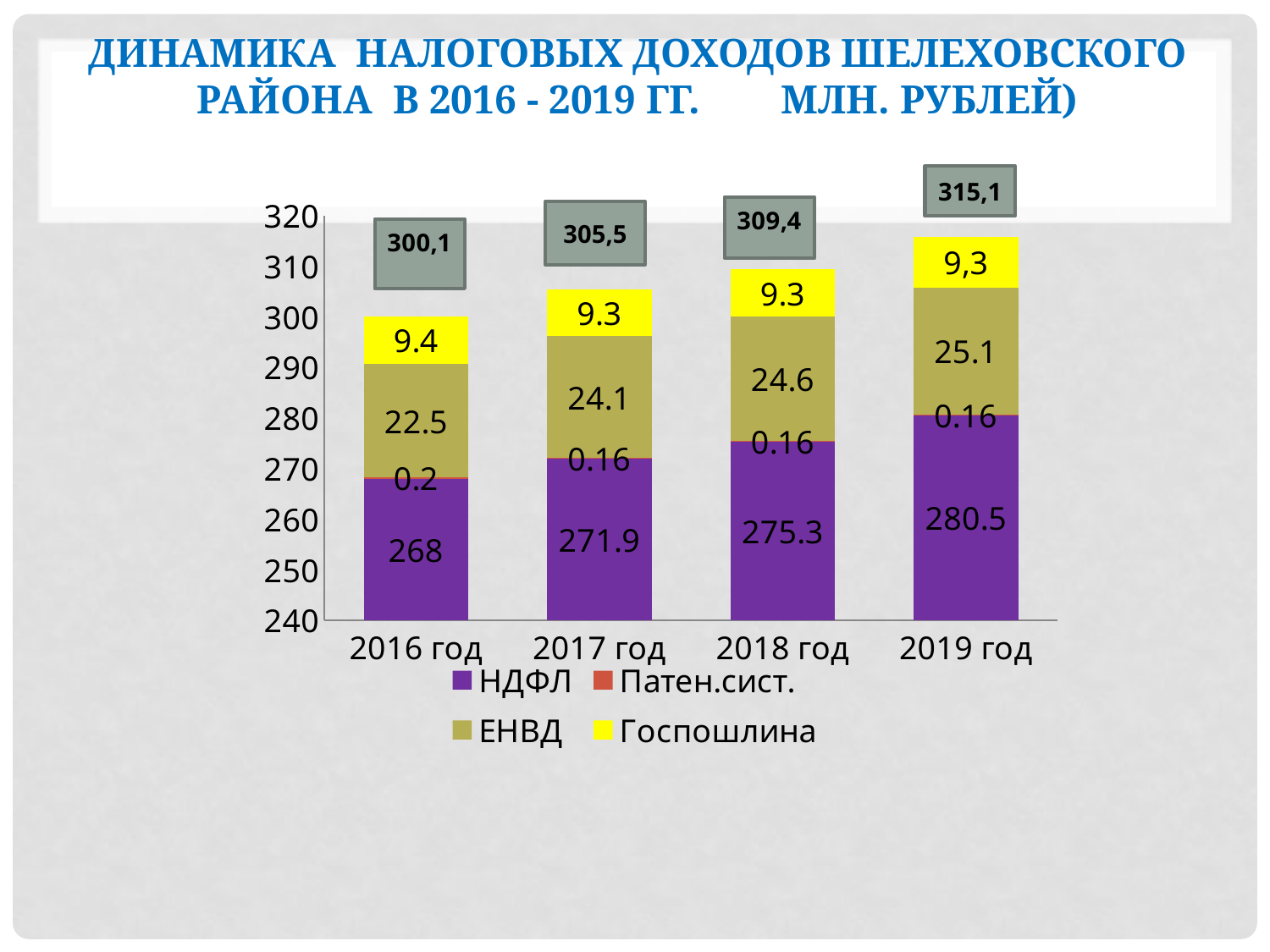
What is the value of Патен.сист. for 2016 год? 0.2 Which is larger: ЕНВД in 2017 год or ЕНВД in 2018 год? 2018 год What is the value of ЕНВД for 2018 год? 24.6 What is the total of the stacked bar for 2018 год? 309,4 In which year is НДФЛ the highest? 2019 год What kind of chart is shown on the slide? Stacked bar chart In which year is ЕНВД the lowest? 2016 год What is the difference between НДФЛ in 2019 год and НДФЛ in 2016 год? 12.5 What is the value of Госпошлина for 2019 год? 9,3 How many years are shown on the x axis? 4 How many series does the legend list? 4 What is the value of НДФЛ for 2016 год? 268